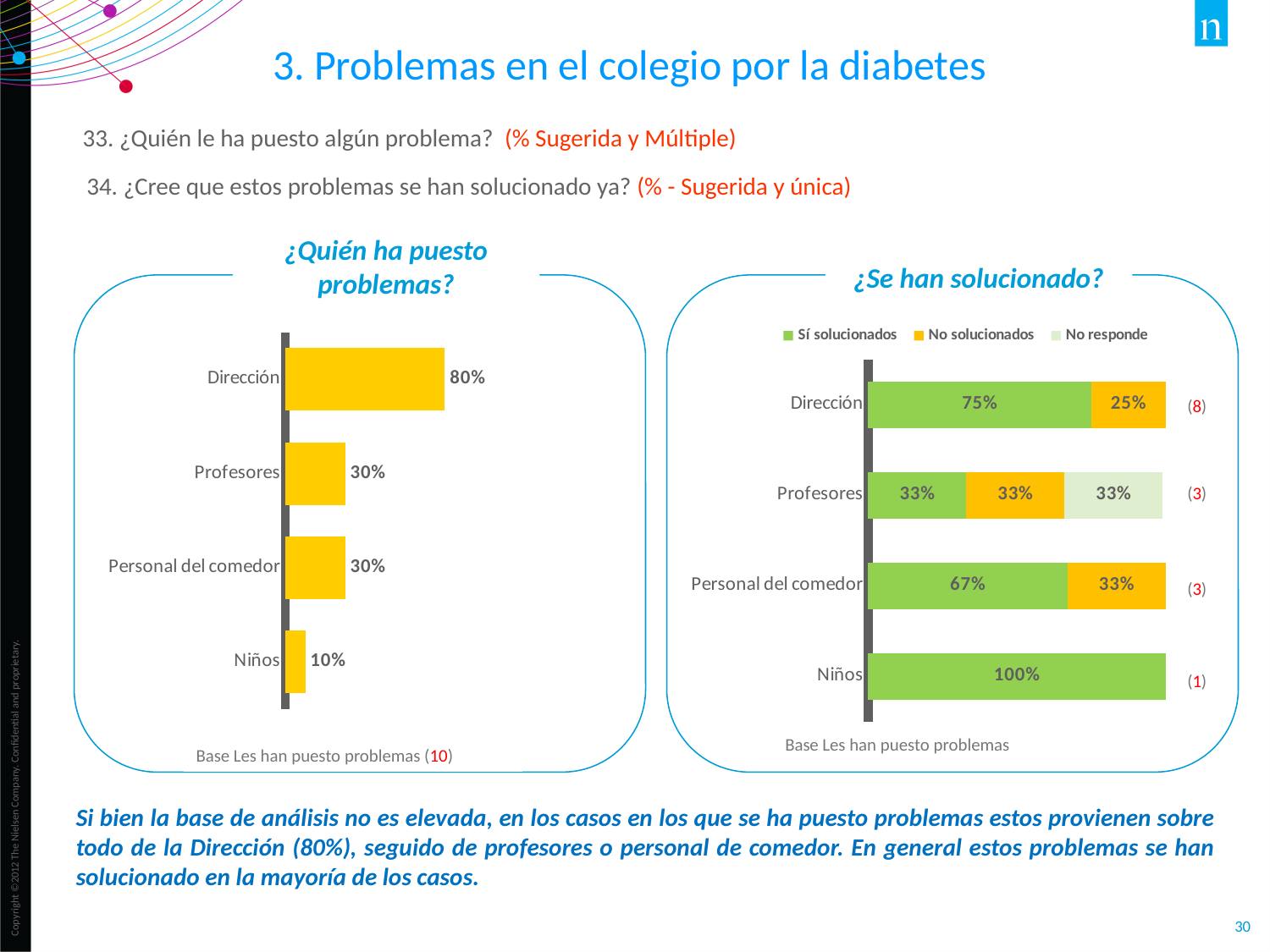
In the '¿Se han solucionado?' chart, what is the 'No solucionados' value for Dirección? 25% In the '¿Quién ha puesto problemas?' chart, what is the value for Dirección? 80% In the '¿Quién ha puesto problemas?' chart, how many categories are shown? 4 In the '¿Se han solucionado?' chart, what is the 'Sí solucionados' value for Personal del comedor? 67% In the '¿Se han solucionado?' chart, how many series does the legend list? 3 In the '¿Se han solucionado?' chart, what is the 'No responde' value for Profesores? 33% In the '¿Se han solucionado?' chart, which category has the highest 'Sí solucionados' value? Niños In the '¿Quién ha puesto problemas?' chart, which category has the lowest value? Niños In the '¿Quién ha puesto problemas?' chart, what is the difference between the values for Dirección and Profesores? 50% What kind of chart is the '¿Quién ha puesto problemas?' chart? Bar chart In the '¿Quién ha puesto problemas?' chart, what is the value for Niños? 10% In the '¿Quién ha puesto problemas?' chart, which category has the highest value? Dirección